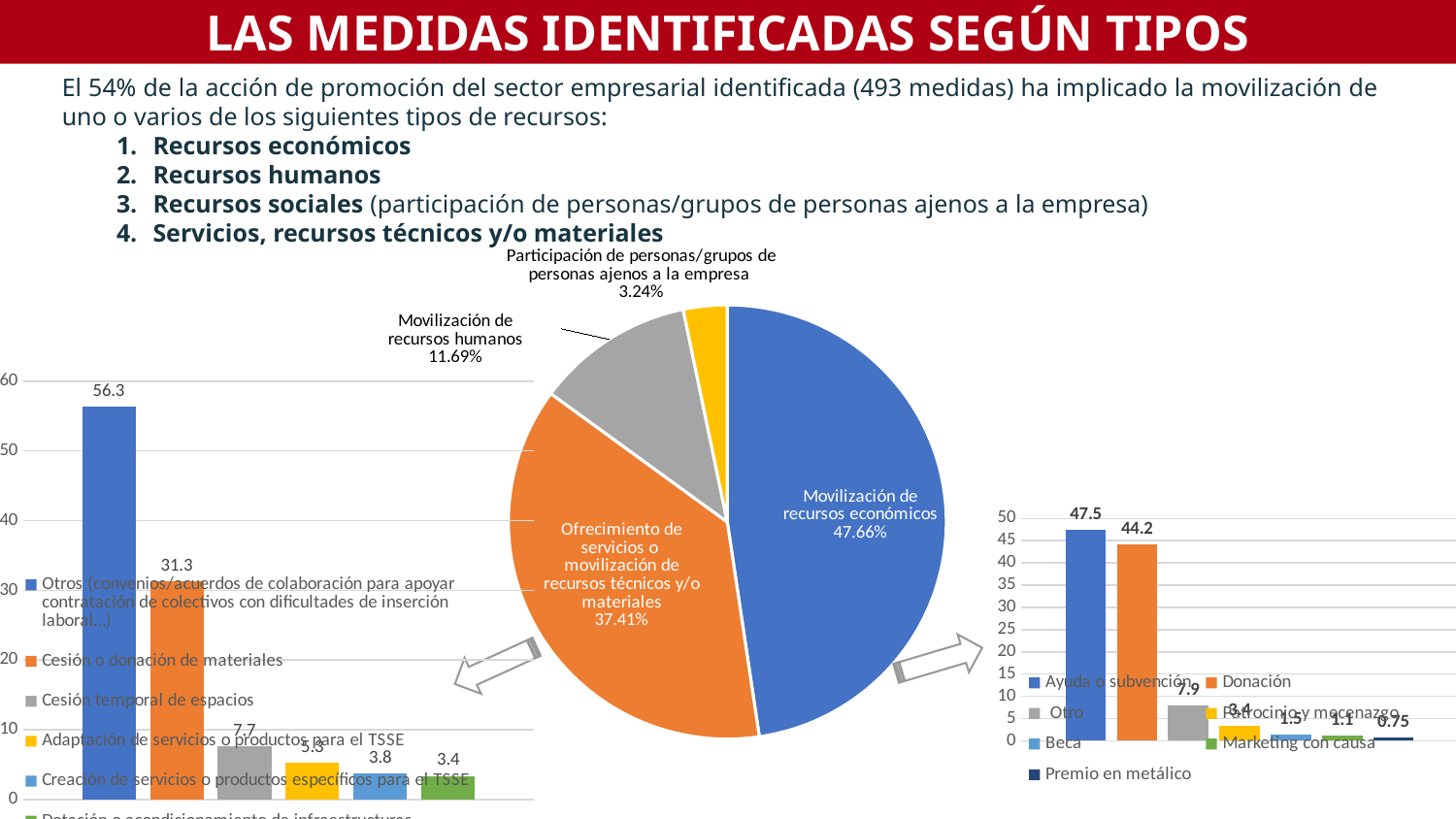
In the pie chart, what share is labelled for 'Movilización de recursos económicos'? 47.66% In the pie chart, what share is labelled for 'Movilización de recursos humanos'? 11.69% In the pie chart, which slice is the smallest? Participación de personas/grupos de personas ajenos a la empresa What kind of chart is the chart on the left of the slide? Bar chart In the bar chart on the right, what is the value for 'Ayuda o subvención'? 47.5 In the bar chart on the left, what is the value of the tallest bar? 56.3 In the bar chart on the right, which category has the highest value? Ayuda o subvención In the pie chart, what is the difference between the 'Movilización de recursos económicos' share and the 'Ofrecimiento de servicios o movilización de recursos técnicos y/o materiales' share? 10.25% How many series does the legend of the bar chart on the right list? 7 How many slices does the pie chart have? 4 In the bar chart on the right, what is the difference between 'Ayuda o subvención' and 'Donación'? 3.3 In the bar chart on the right, what is the value for 'Premio en metálico'? 0.75